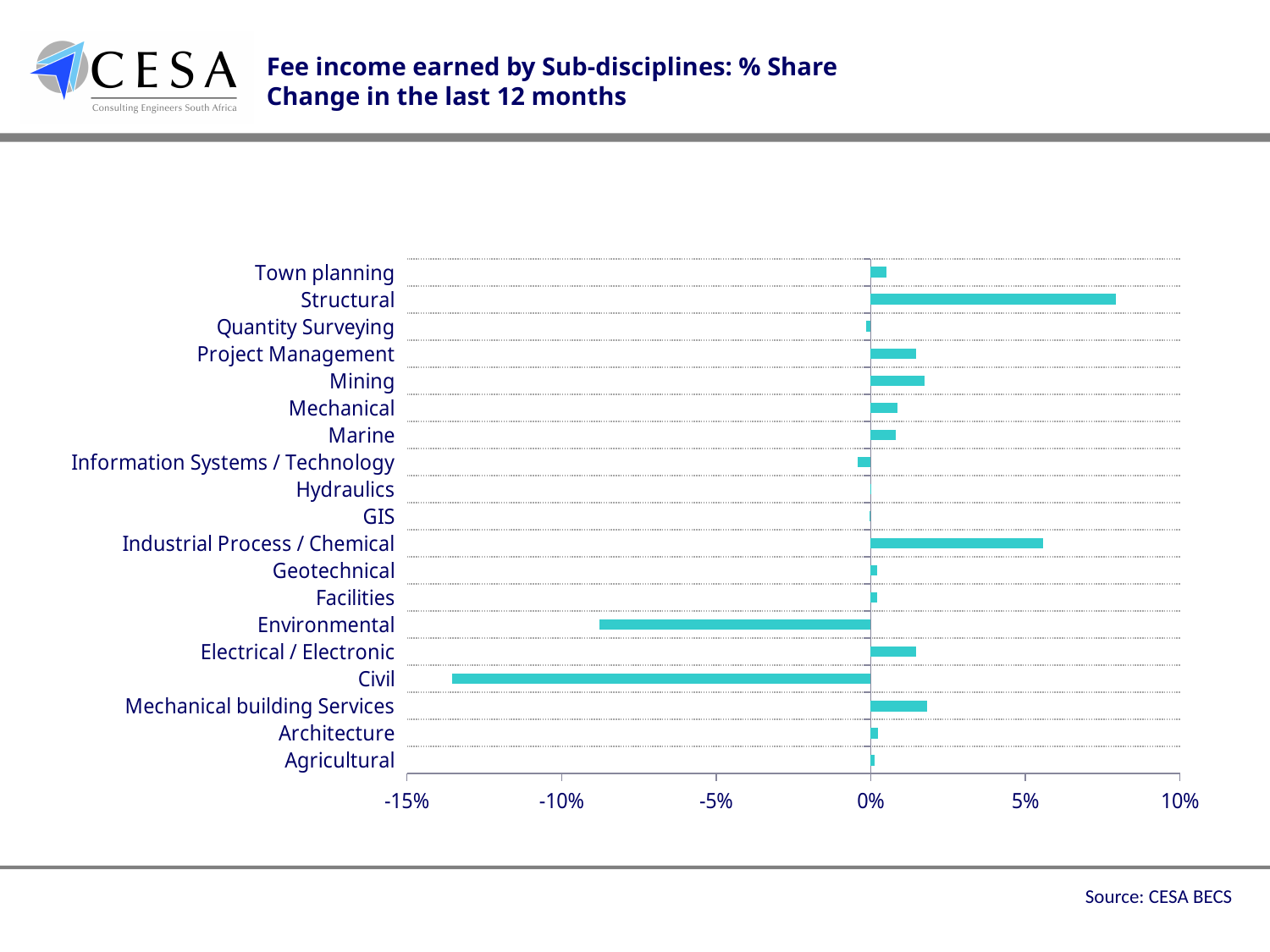
Which shows the larger decline, Civil or Environmental? Civil Is the value for Mining greater or less than 0%? greater What kind of chart is shown on the slide? Bar chart Is the value for Structural greater or less than 5%? greater How many sub-disciplines are listed on the chart? 19 Which has the larger % share change, Structural or Industrial Process / Chemical? Structural Is the value for Civil greater or less than -10%? less Which sub-discipline has the highest % share change? Structural Which sub-discipline has the lowest % share change? Civil Which has the larger % share change, Project Management or Town planning? Project Management What is the source cited for the chart? CESA BECS